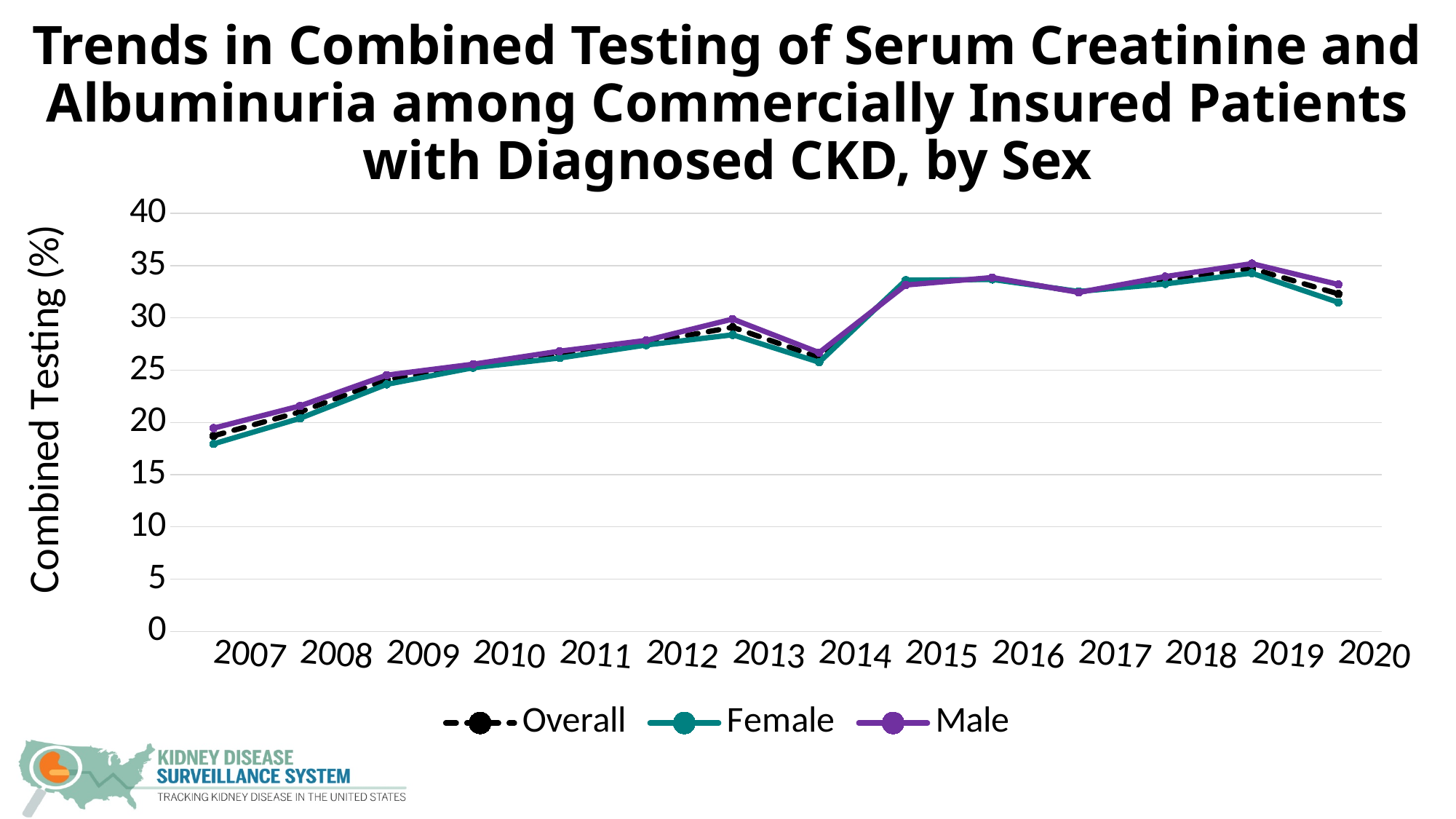
In which year does the Male series reach its highest value? 2019 Is the value for Female in 2007 greater or less than 20? less Is the value for Female in 2009 greater or less than 25? less Which series are listed in the legend? Overall, Female, Male How many years are plotted along the x axis? 14 In 2007, which is larger, the Male value or the Female value? Male Is the value for Male in 2019 greater or less than 30? greater How many series does the legend list? 3 What is the label of the y axis? Combined Testing (%) What kind of chart is shown on the slide? line chart In 2020, which is larger, the Male value or the Female value? Male Do the values for the Overall series rise or fall from 2007 to 2013? rise